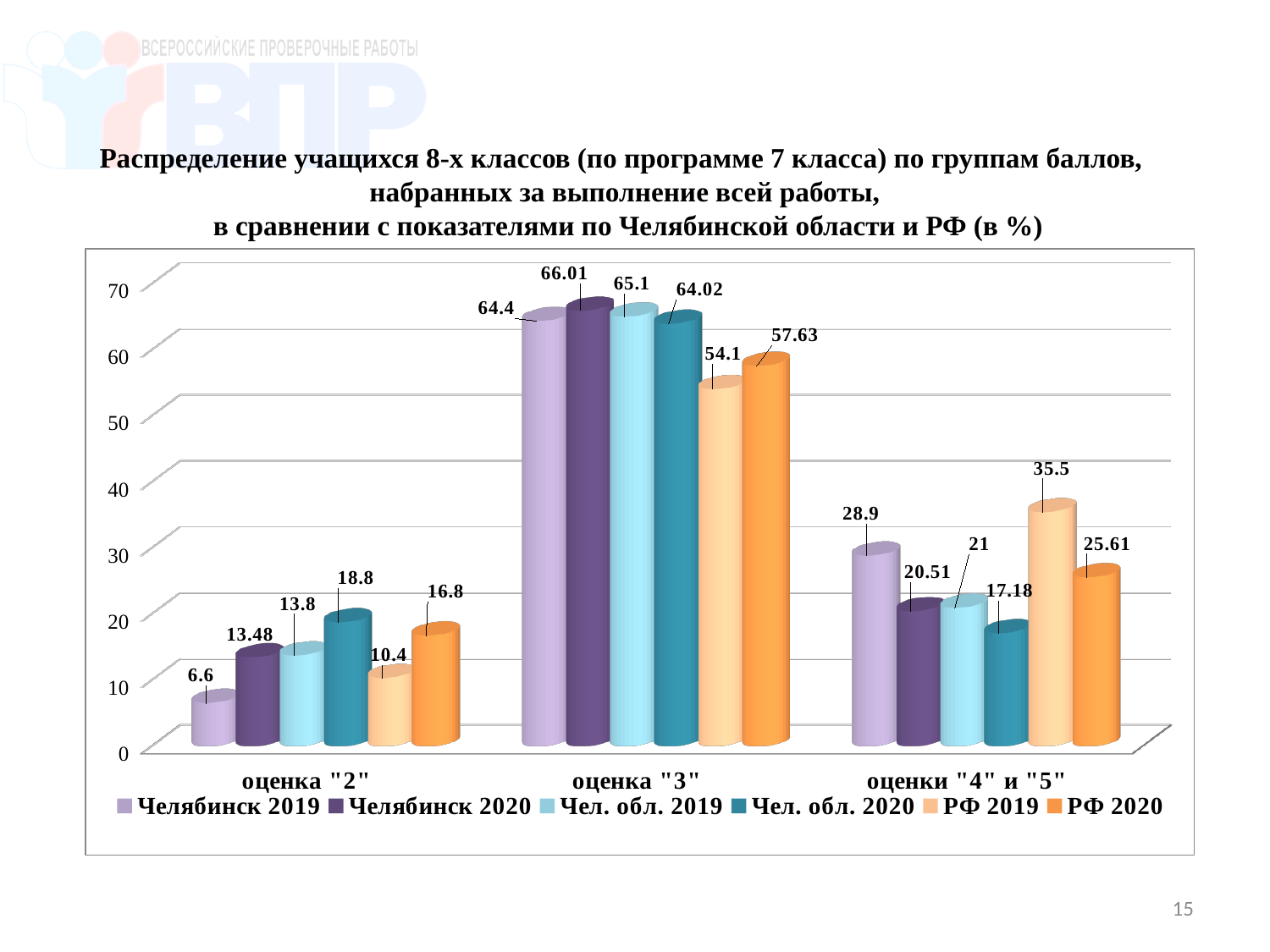
What is the difference between Челябинск 2020 and Челябинск 2019 in the оценка "2" category? 6.88 How many series does the legend list? 6 What is the value for Чел. обл. 2020 in the оценки "4" и "5" category? 17.18 What kind of chart is shown on the slide? bar chart How many categories are shown on the x axis? 3 Which series is shown in orange in the legend? РФ 2020 Which series has the lowest value in the оценка "3" category? РФ 2019 Which is larger in the оценка "3" category: Челябинск 2020 or Чел. обл. 2020? Челябинск 2020 Which series has the highest value in the оценки "4" и "5" category? РФ 2019 What is the value for РФ 2020 in the оценка "3" category? 57.63 What is the value for Челябинск 2019 in the оценка "2" category? 6.6 Is the value for РФ 2019 in the оценки "4" и "5" category greater or less than 30? greater